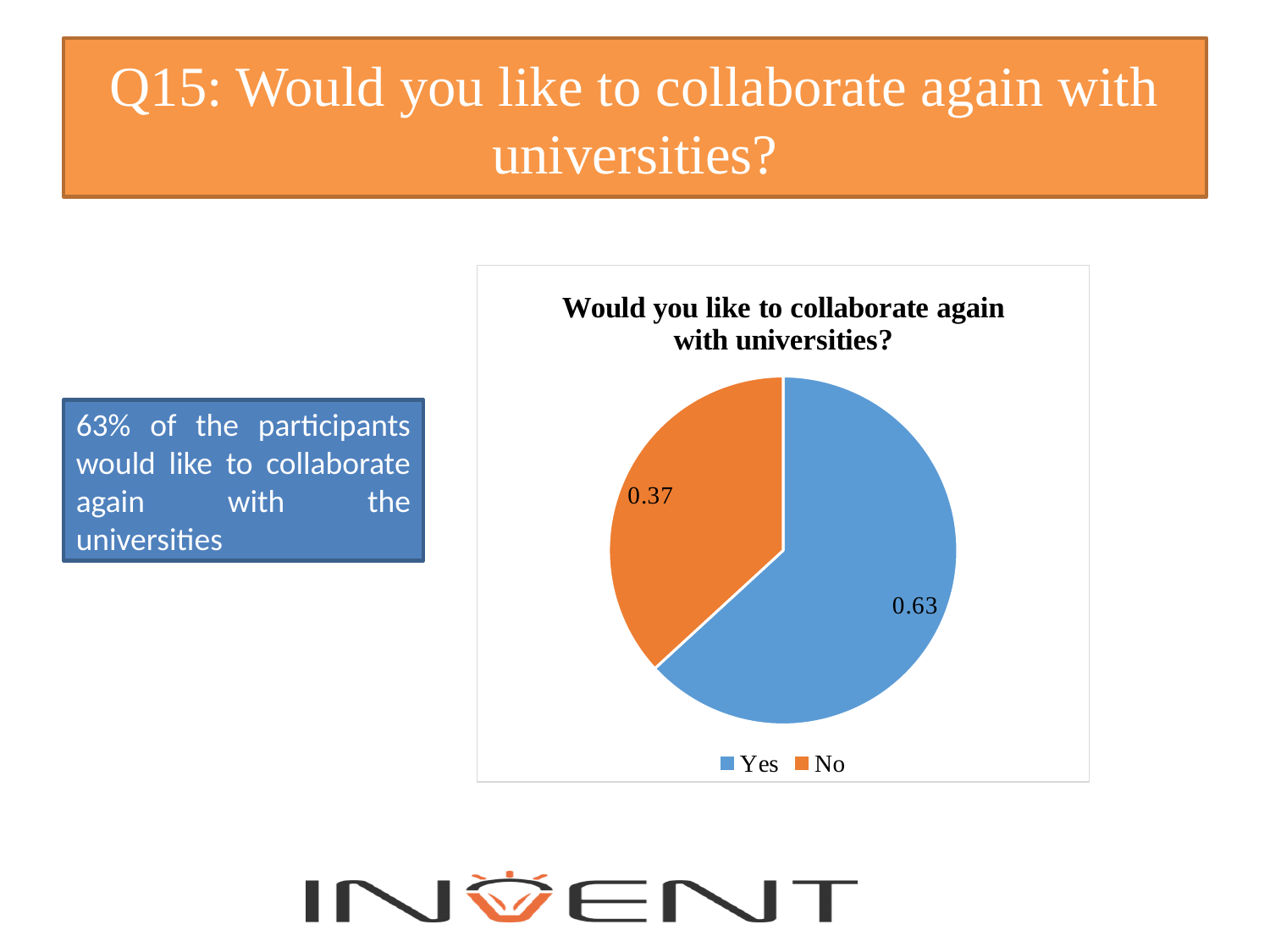
What is the value shown for the Yes slice? 0.63 Which slice is the smallest? No What is the title of the chart? Would you like to collaborate again with universities? How many entries does the legend list? 2 What is the value shown for the No slice? 0.37 What is the difference between the Yes value and the No value? 0.26 How many slices does the pie chart have? 2 What type of chart is shown on the slide? pie chart Which slice is the largest? Yes What colour is the Yes slice? blue Which is larger, the Yes slice or the No slice? Yes